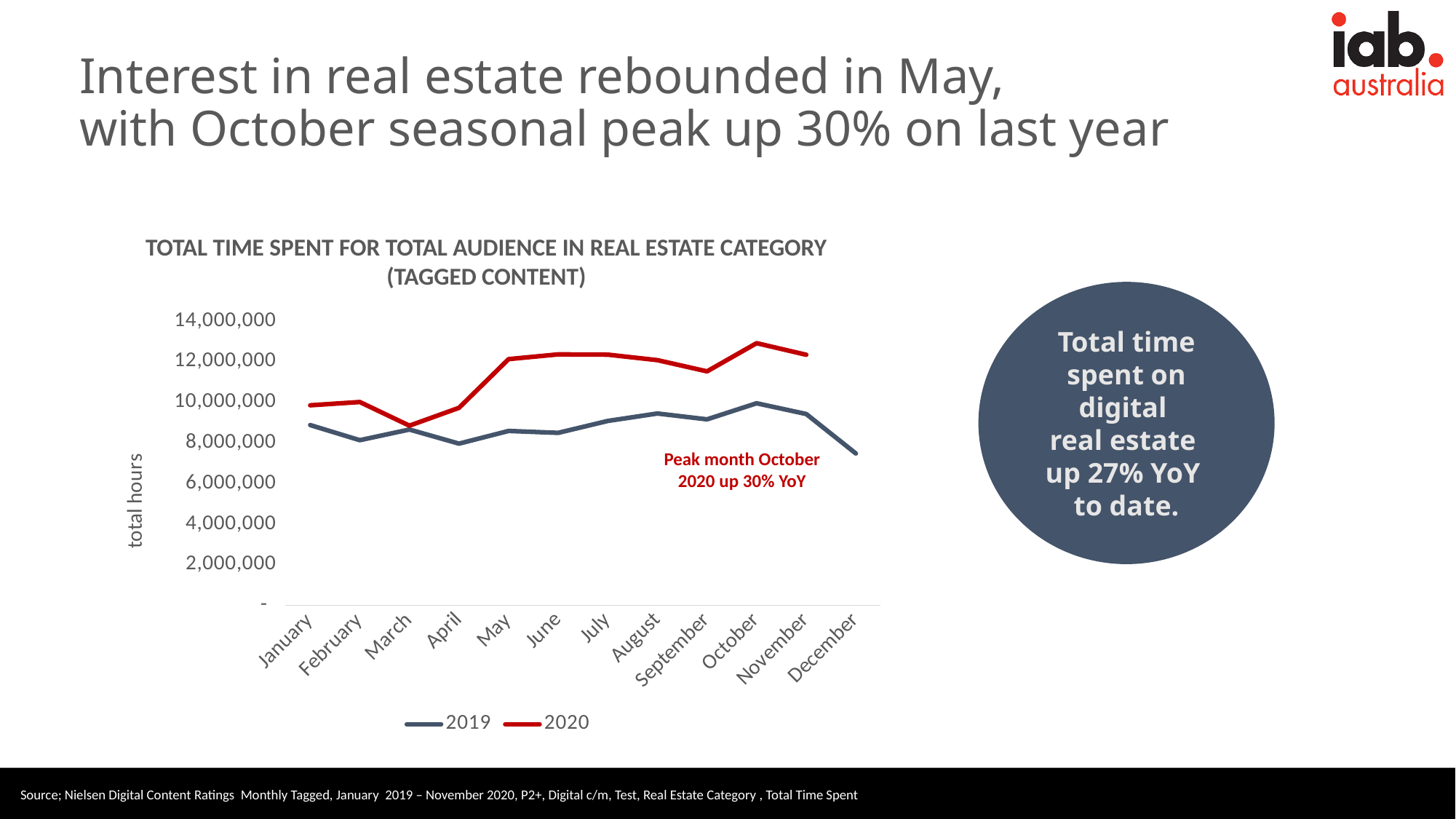
What is the label on the vertical axis of the chart? total hours Is the 2020 value for May greater or less than 10,000,000? greater In which month does the 2020 line reach its highest value? October Is the 2019 value for December greater or less than 8,000,000? less Which series has the larger value in October, 2019 or 2020? 2020 In which month does the 2020 line reach its lowest value? March How many series does the chart legend list? 2 In which month does the 2019 line reach its lowest value? December Does the 2020 line rise or fall from March to May? rise What kind of chart is shown on the slide? Line chart How many months are shown on the x axis of the chart? 12 Is the 2020 value for October greater or less than 12,000,000? greater